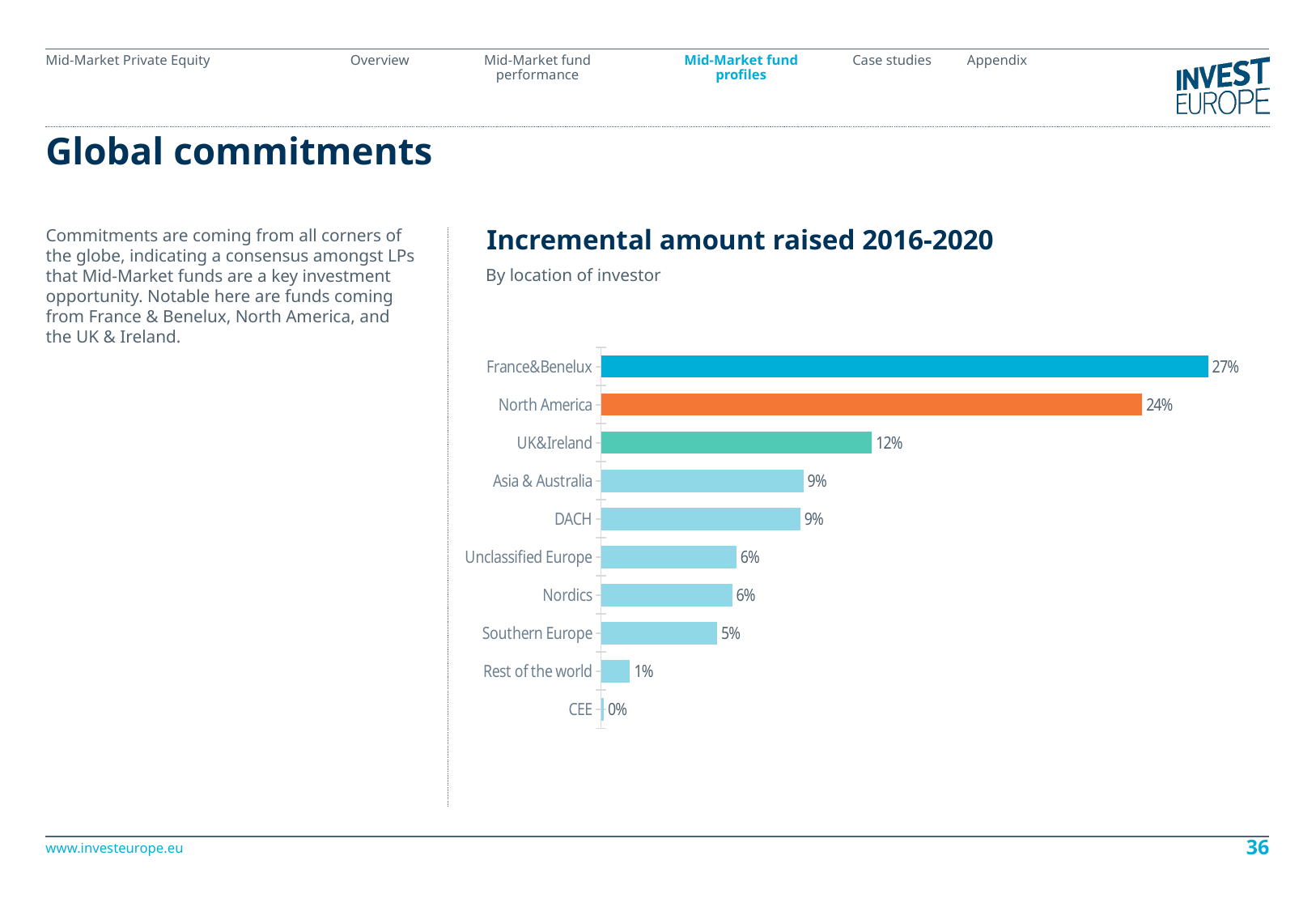
Which is larger, Asia & Australia or Unclassified Europe? Asia & Australia What is the value for Southern Europe? 5% What is the difference between UK&Ireland and Nordics? 6% What is the difference between France&Benelux and North America? 3% What is the value for France&Benelux? 27% Which location has the lowest value? CEE How many locations are shown in the chart? 10 Which location has the highest value? France&Benelux What kind of chart is shown? Bar chart What is the value for North America? 24% What is the value for CEE? 0% What is the value for UK&Ireland? 12%